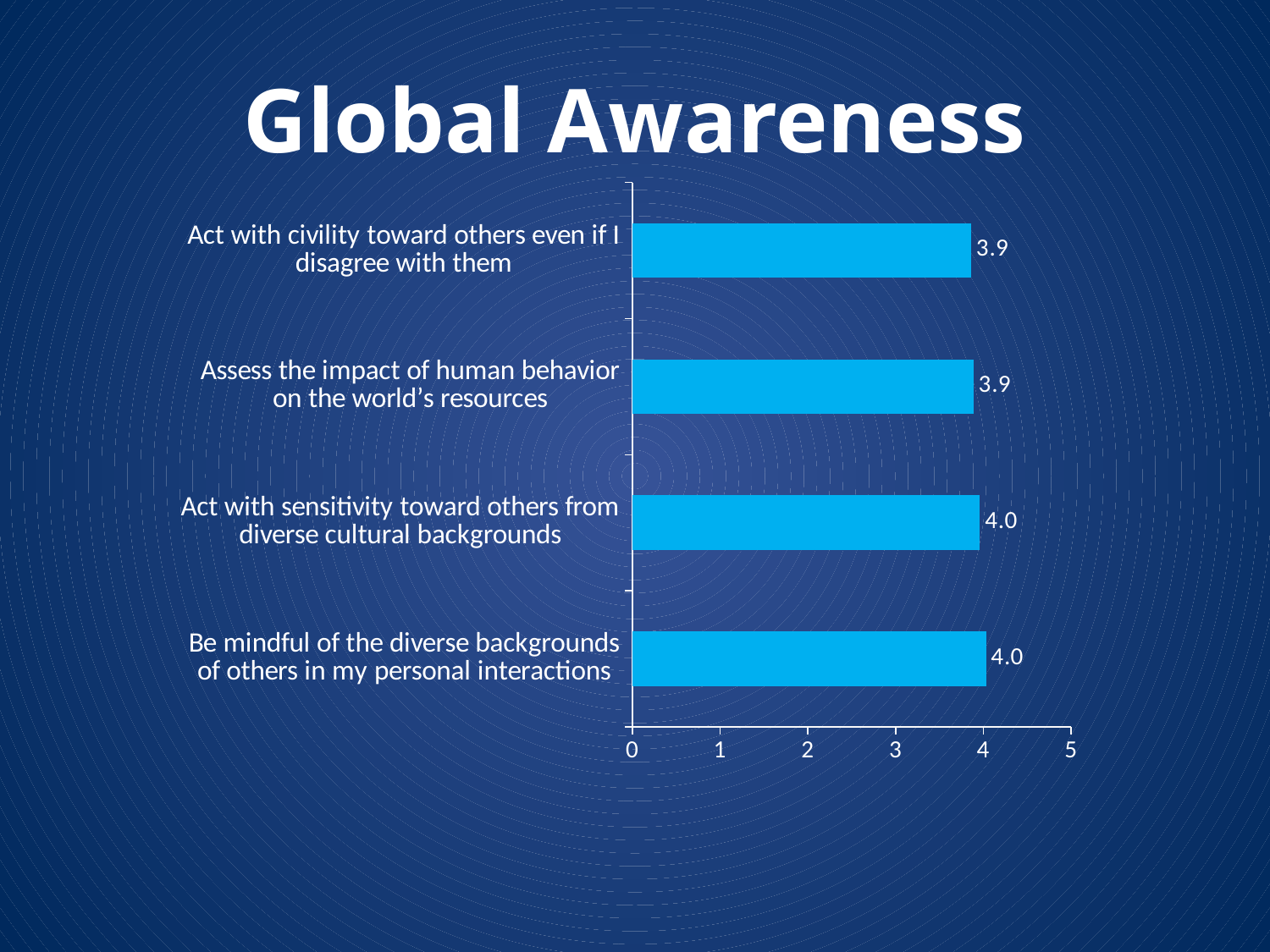
What is the difference between the value for "Be mindful of the diverse backgrounds of others in my personal interactions" and the value for "Act with civility toward others even if I disagree with them"? 0.1 What value is shown for "Assess the impact of human behavior on the world's resources"? 3.9 What value is shown for "Act with civility toward others even if I disagree with them"? 3.9 How many categories are shown in the chart? 4 What is the highest value shown on the horizontal axis of the chart? 5 Is the value for "Be mindful of the diverse backgrounds of others in my personal interactions" greater or less than 5? less What value is shown for "Be mindful of the diverse backgrounds of others in my personal interactions"? 4.0 What is the title of the slide containing the chart? Global Awareness What kind of chart is shown on the slide? Bar chart Which has the larger value: "Act with sensitivity toward others from diverse cultural backgrounds" or "Assess the impact of human behavior on the world's resources"? Act with sensitivity toward others from diverse cultural backgrounds Is the value for "Assess the impact of human behavior on the world's resources" greater or less than 3? greater What value is shown for "Act with sensitivity toward others from diverse cultural backgrounds"? 4.0